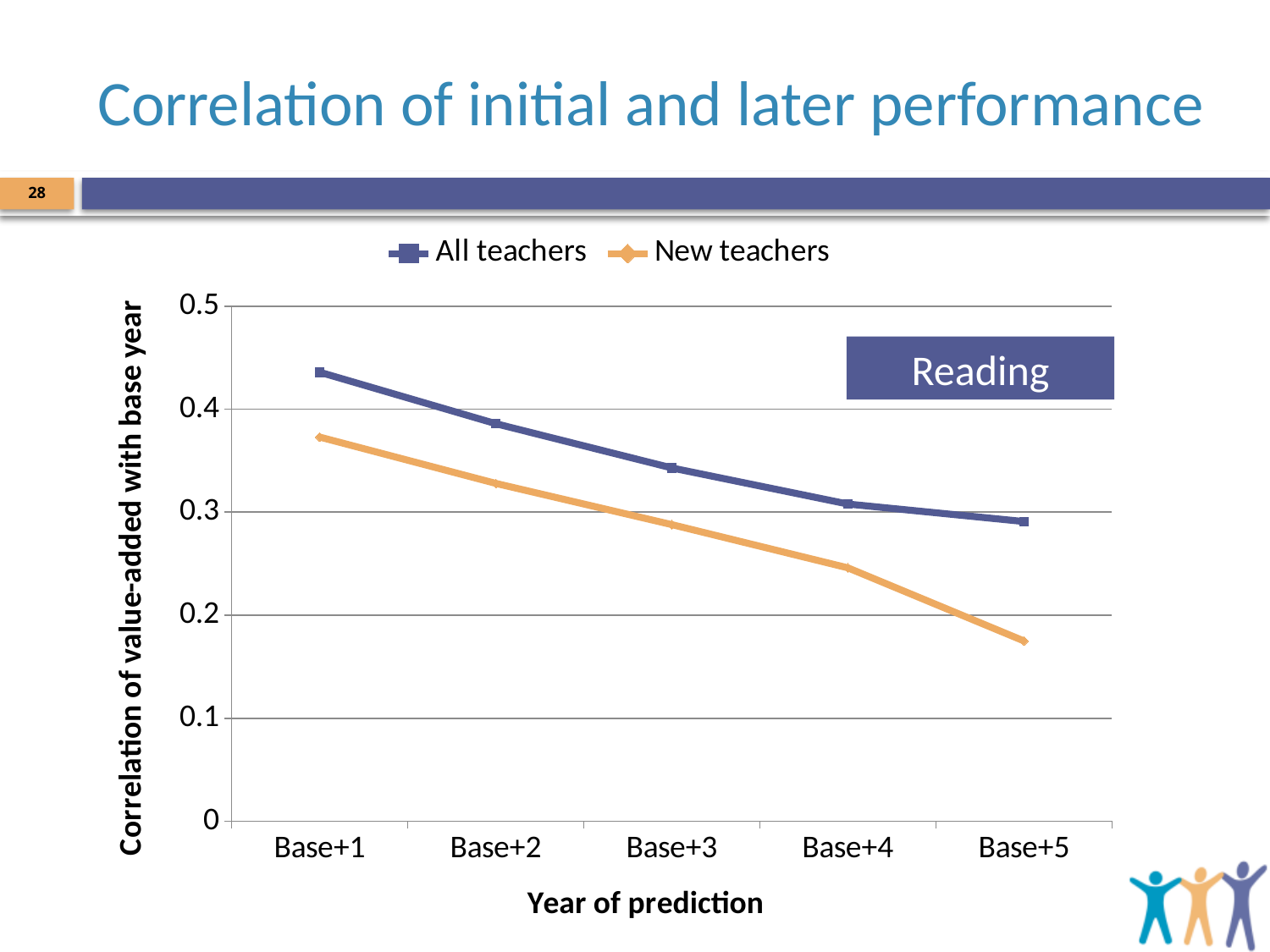
Is the value for New teachers at Base+5 greater or less than 0.2? less Do the values for New teachers rise or fall from Base+1 to Base+5? fall Is the value for New teachers at Base+1 greater or less than 0.4? less Is the value for All teachers at Base+3 greater or less than 0.3? greater How many series does the legend list? 2 At which year of prediction is the New teachers series lowest? Base+5 Do the values for All teachers rise or fall from Base+1 to Base+5? fall What kind of chart is shown on the slide? line chart How many years of prediction are plotted along the x axis? 5 At Base+5, which series has the larger value, All teachers or New teachers? All teachers What subject label is shown in the box inside the chart area? Reading